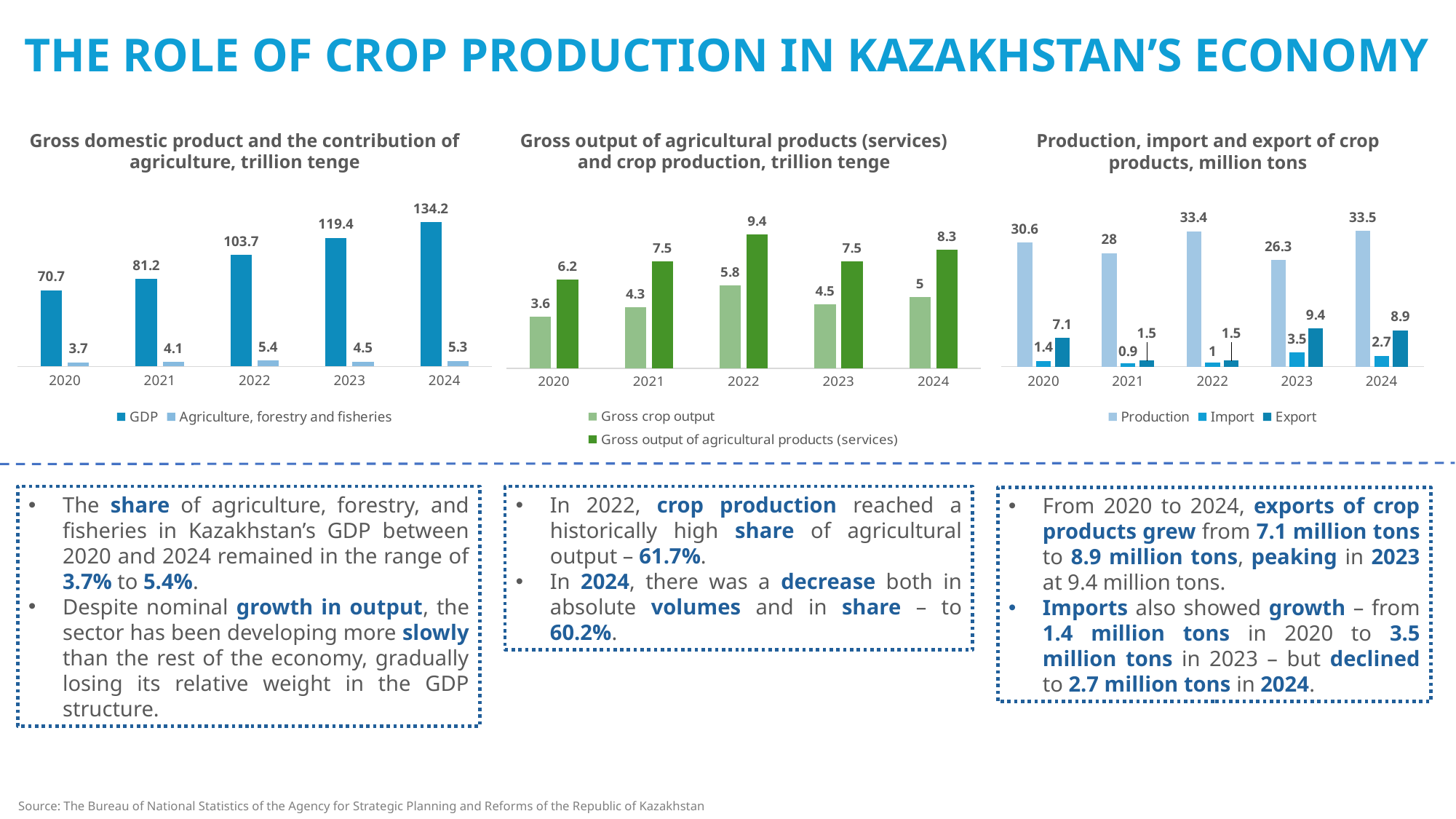
In the 'Gross domestic product and the contribution of agriculture' chart, which year has the highest value for Agriculture, forestry and fisheries? 2022 In the 'Gross output of agricultural products (services) and crop production' chart, what is the gross crop output for 2022? 5.8 In the 'Gross output of agricultural products (services) and crop production' chart, which year has the lowest gross output of agricultural products (services)? 2020 In the 'Production, import and export of crop products' chart, how many years are shown on the x axis? 5 In the 'Production, import and export of crop products' chart, which year has the highest production? 2024 In the 'Gross domestic product and the contribution of agriculture' chart, what is the GDP value for 2024? 134.2 What type of chart is the 'Production, import and export of crop products' chart? bar chart In the 'Gross domestic product and the contribution of agriculture' chart, what is the difference between GDP in 2024 and GDP in 2020? 63.5 In the 'Production, import and export of crop products' chart, is the import value for 2023 larger or the import value for 2024? 2023 In the 'Gross domestic product and the contribution of agriculture' chart, does GDP rise or fall from 2020 to 2024? rise In the 'Production, import and export of crop products' chart, what is the export value for 2023? 9.4 In the 'Gross output of agricultural products (services) and crop production' chart, how many series does the legend list? 2